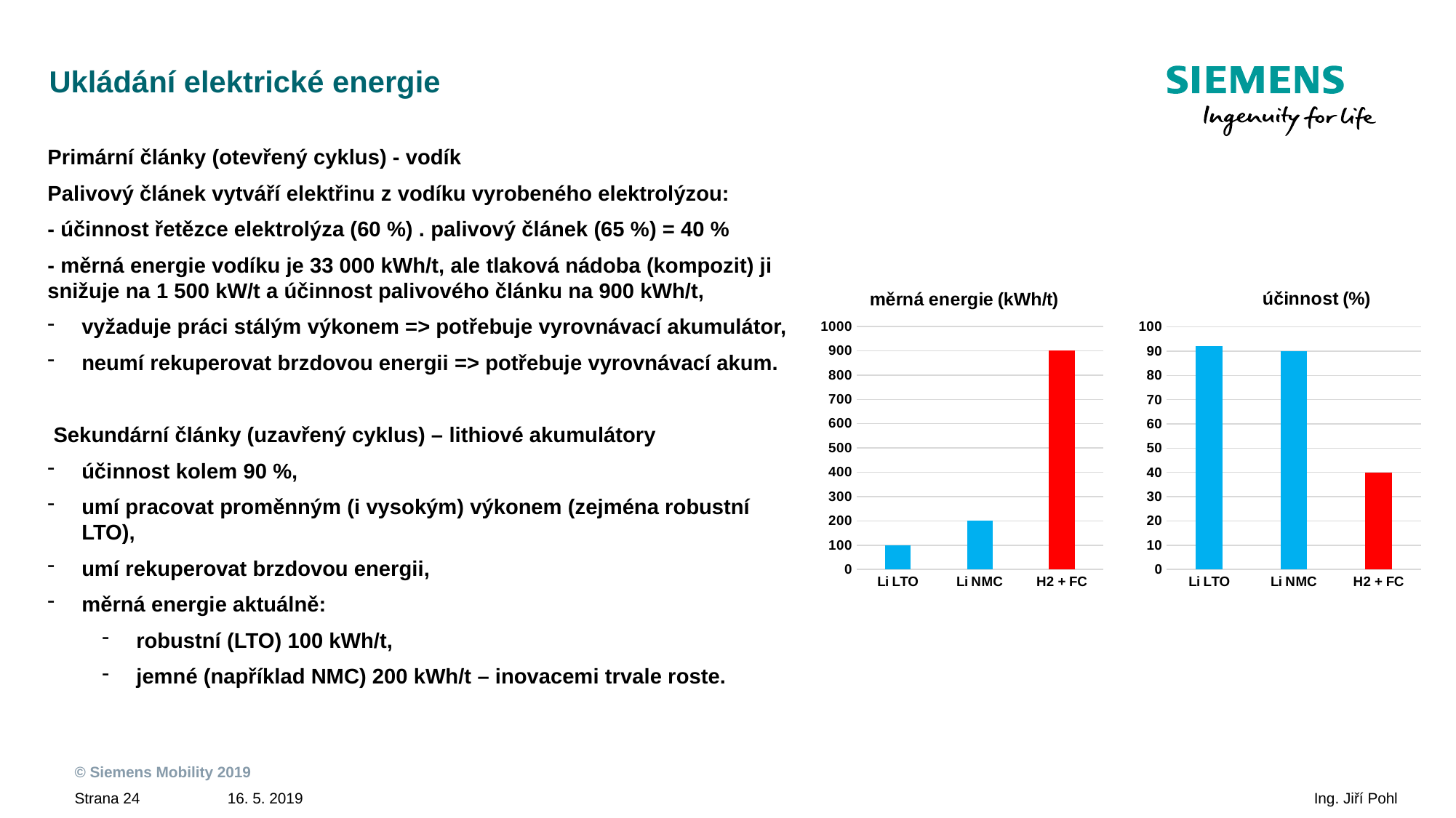
In the chart titled 'měrná energie (kWh/t)', what is the difference between the values for H2 + FC and Li NMC? 700 What kind of chart is the chart titled 'účinnost (%)'? bar chart How many categories are shown in the chart titled 'měrná energie (kWh/t)'? 3 In the chart titled 'účinnost (%)', what colour is the bar for H2 + FC? red In the chart titled 'účinnost (%)', what is the value for H2 + FC? 40 In the chart titled 'účinnost (%)', which category has the lowest value? H2 + FC In the chart titled 'měrná energie (kWh/t)', what is the value for H2 + FC? 900 In the chart titled 'účinnost (%)', which is larger, the value for Li NMC or the value for H2 + FC? Li NMC In the chart titled 'měrná energie (kWh/t)', what is the value for Li NMC? 200 In the chart titled 'účinnost (%)', is the value for Li LTO greater or less than 80? greater In the chart titled 'měrná energie (kWh/t)', which category has the highest value? H2 + FC In the chart titled 'měrná energie (kWh/t)', which category has the lowest value? Li LTO